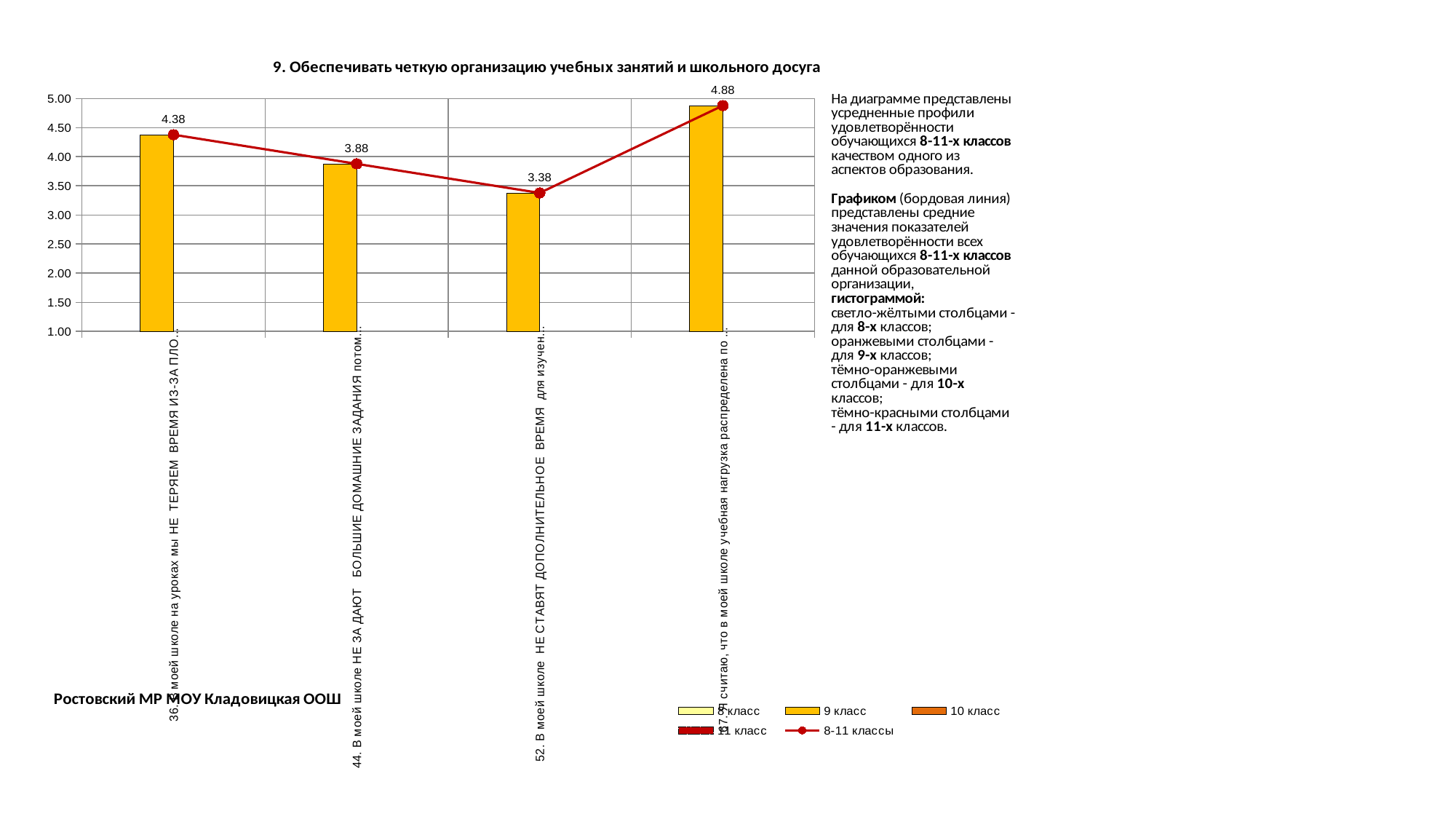
What kind of chart is shown on the slide? A bar chart combined with a line What value does the 8-11 классы line show for the category labelled 52? 3.38 How many categories are plotted on the x axis? 4 What value does the 8-11 классы line show for the first category (question 36)? 4.38 Which is larger: the value for category 36 or the value for category 44? Category 36 What is the difference between the highest and lowest values on the 8-11 классы line? 1.50 Which category has the lowest value on the 8-11 классы line? 52 (the third category) Is the value for category 44 greater or less than 3.50? greater How many series does the legend list? 5 Which category has the highest value on the 8-11 классы line? 67 (the last category) What value does the 8-11 классы line show for the category labelled 44? 3.88